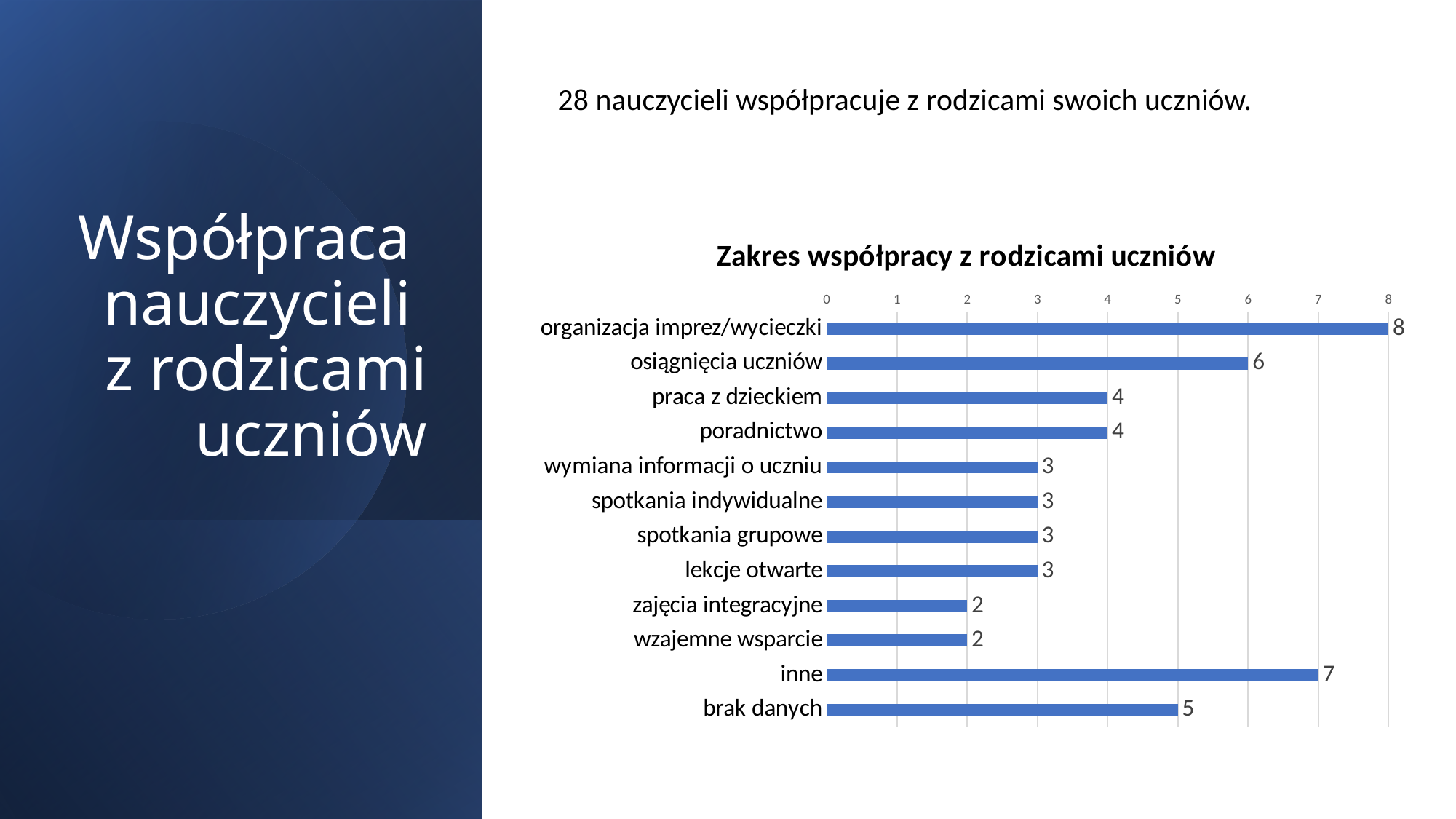
What is the value for "organizacja imprez/wycieczki"? 8 How many categories are shown in the chart? 12 How many categories have a value of 3? 4 What is the value for "poradnictwo"? 4 What is the value for "inne"? 7 What is the difference between "organizacja imprez/wycieczki" and "osiągnięcia uczniów"? 2 Which category has the highest value? organizacja imprez/wycieczki What is the value for "brak danych"? 5 What is the title of the chart? Zakres współpracy z rodzicami uczniów Is the value for "osiągnięcia uczniów" greater or less than 5? greater Which is larger, the value for "inne" or the value for "brak danych"? inne What kind of chart is shown on the slide? bar chart